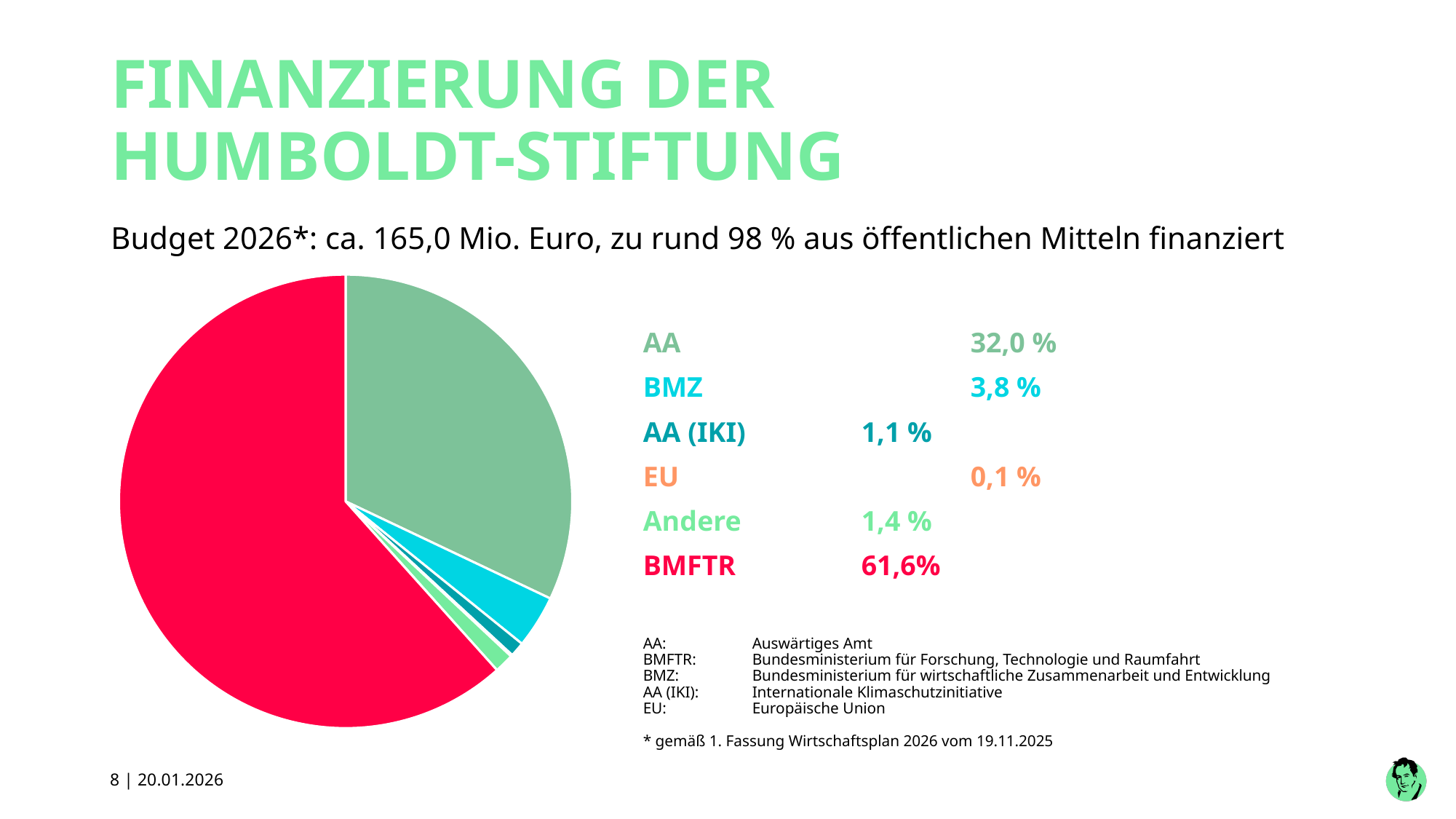
What share of the Humboldt-Stiftung funding comes from AA according to the pie chart? 32,0 % What percentage of the funding comes from the EU? 0,1 % How many percentage points larger is the BMFTR share than the AA share? 29,6 % Which funding source has the largest slice of the pie chart? BMFTR What percentage is shown for BMZ in the pie chart? 3,8 % Which funding source has the smallest slice of the pie chart? EU What value is given for AA (IKI)? 1,1 % What share of the pie does BMFTR account for? 61,6% How many funding sources (slices) does the pie chart show? 6 Which is larger, the share for BMZ or the share for Andere? BMZ What colour is the BMFTR slice in the pie chart? red What type of chart is shown on the slide? pie chart